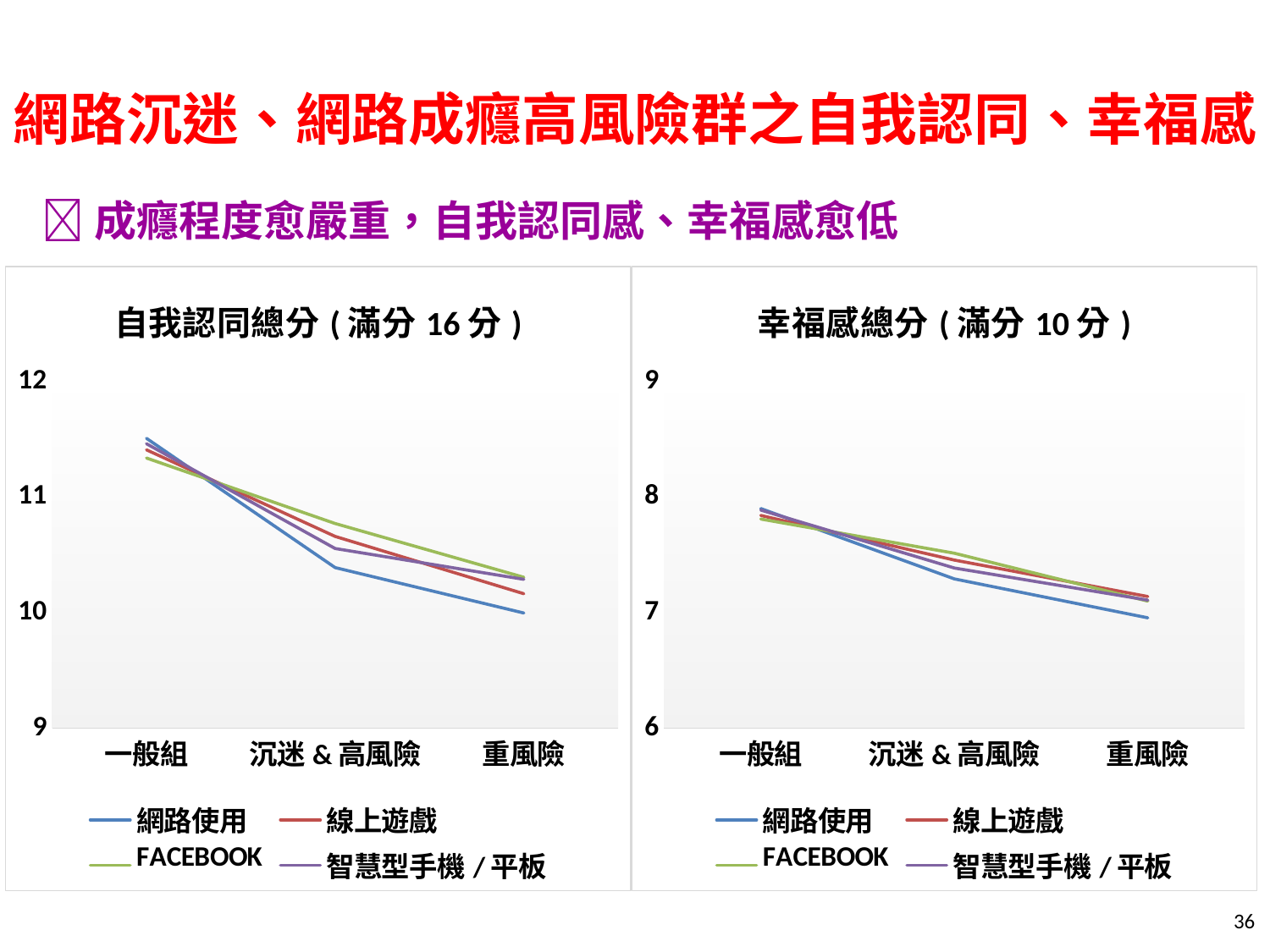
How many series does the legend of the 幸福感總分（滿分 10 分） chart list? 4 In the 幸福感總分（滿分 10 分） chart, which series has the lowest value at 重風險? 網路使用 What type of chart is the 自我認同總分（滿分 16 分） chart? line chart In the 自我認同總分（滿分 16 分） chart, is the value for 網路使用 at 一般組 greater or less than 11? greater In the 自我認同總分（滿分 16 分） chart, is the value for FACEBOOK at 重風險 greater or less than 10? greater What is the title of the chart on the right side of the slide? 幸福感總分（滿分 10 分） In the 自我認同總分（滿分 16 分） chart, do the values for 網路使用 rise or fall from 一般組 to 重風險? fall In the 自我認同總分（滿分 16 分） chart, at 沉迷 & 高風險, which is larger: FACEBOOK or 網路使用? FACEBOOK How many categories are shown on the x axis of the 自我認同總分（滿分 16 分） chart? 3 In the 幸福感總分（滿分 10 分） chart, do the values for FACEBOOK rise or fall from 一般組 to 重風險? fall In the 幸福感總分（滿分 10 分） chart, is the value for 網路使用 at 一般組 greater or less than 8? less In the 自我認同總分（滿分 16 分） chart, which series has the lowest value at 重風險? 網路使用